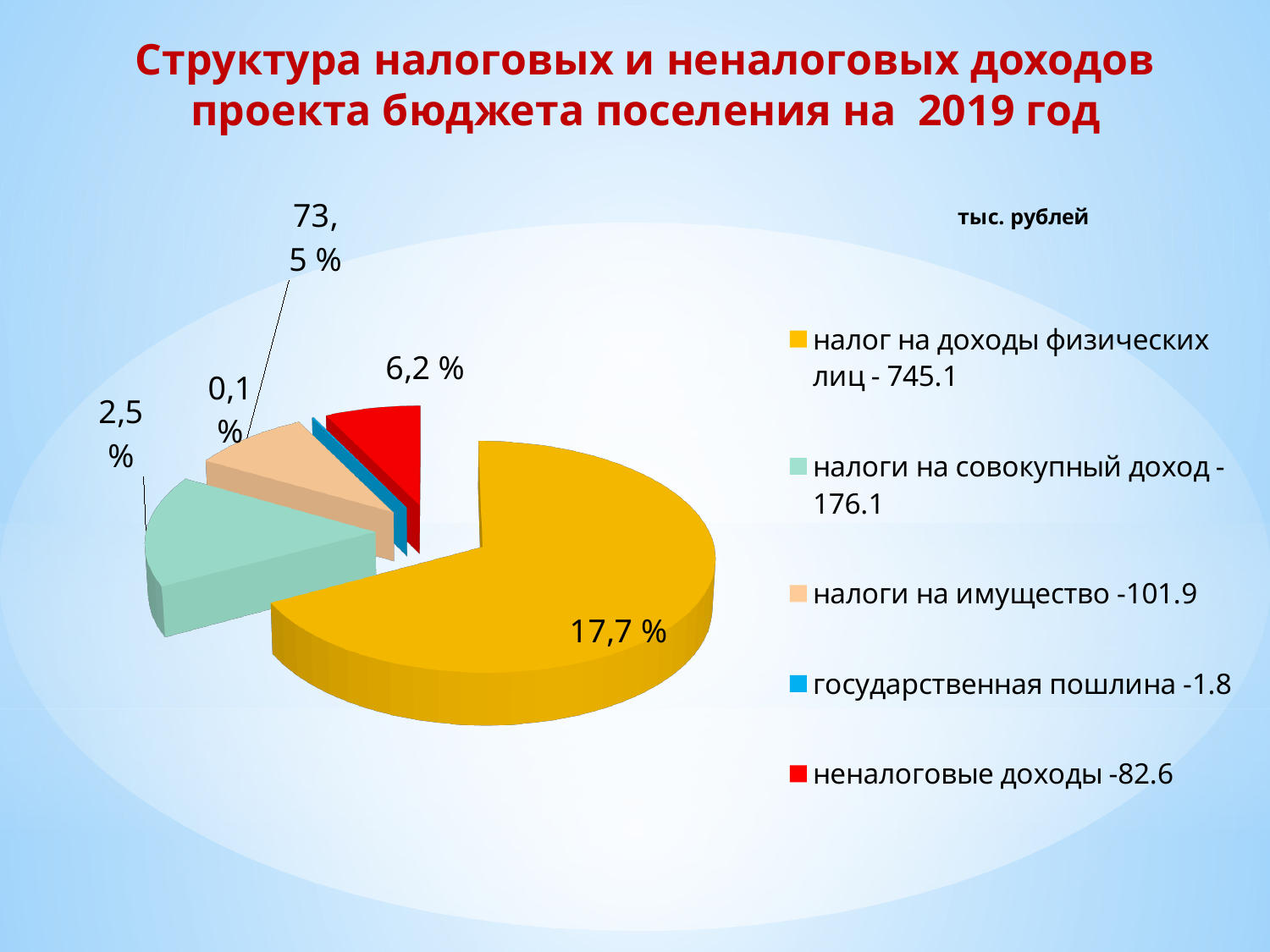
How many categories does the legend of the pie chart list? 5 Which category has the largest slice of the pie? налог на доходы физических лиц Which category has the smallest value in the legend? государственная пошлина What kind of chart is shown on the slide? pie chart What is the difference between the legend values for налог на доходы физических лиц and налоги на совокупный доход? 569.0 What unit is stated for the values on the chart? тыс. рублей What value is given in the legend for налоги на имущество? 101.9 What value is given in the legend for налог на доходы физических лиц? 745.1 What value is given in the legend for государственная пошлина? 1.8 What value is given in the legend for неналоговые доходы? 82.6 Which is larger, налоги на имущество or неналоговые доходы? налоги на имущество What value is given in the legend for налоги на совокупный доход? 176.1